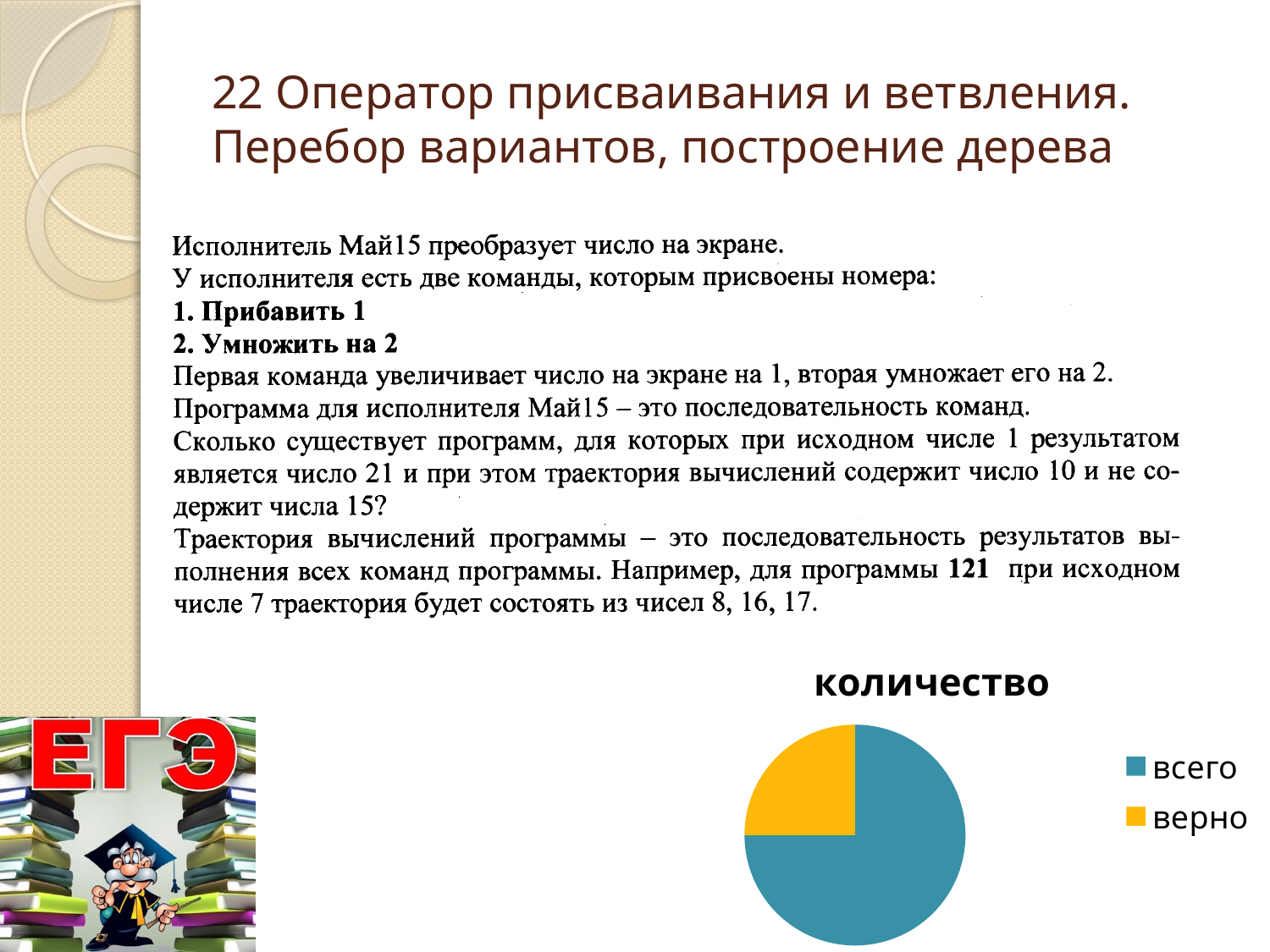
Which is larger in the pie chart, всего or верно? всего What colour is the slice for верно in the pie chart? yellow Which slice of the pie chart is the smallest? верно What kind of chart is shown on the slide? pie chart What is the title of the chart? количество How many slices does the pie chart have? 2 Which slice of the pie chart is the largest? всего How many entries does the chart legend list? 2